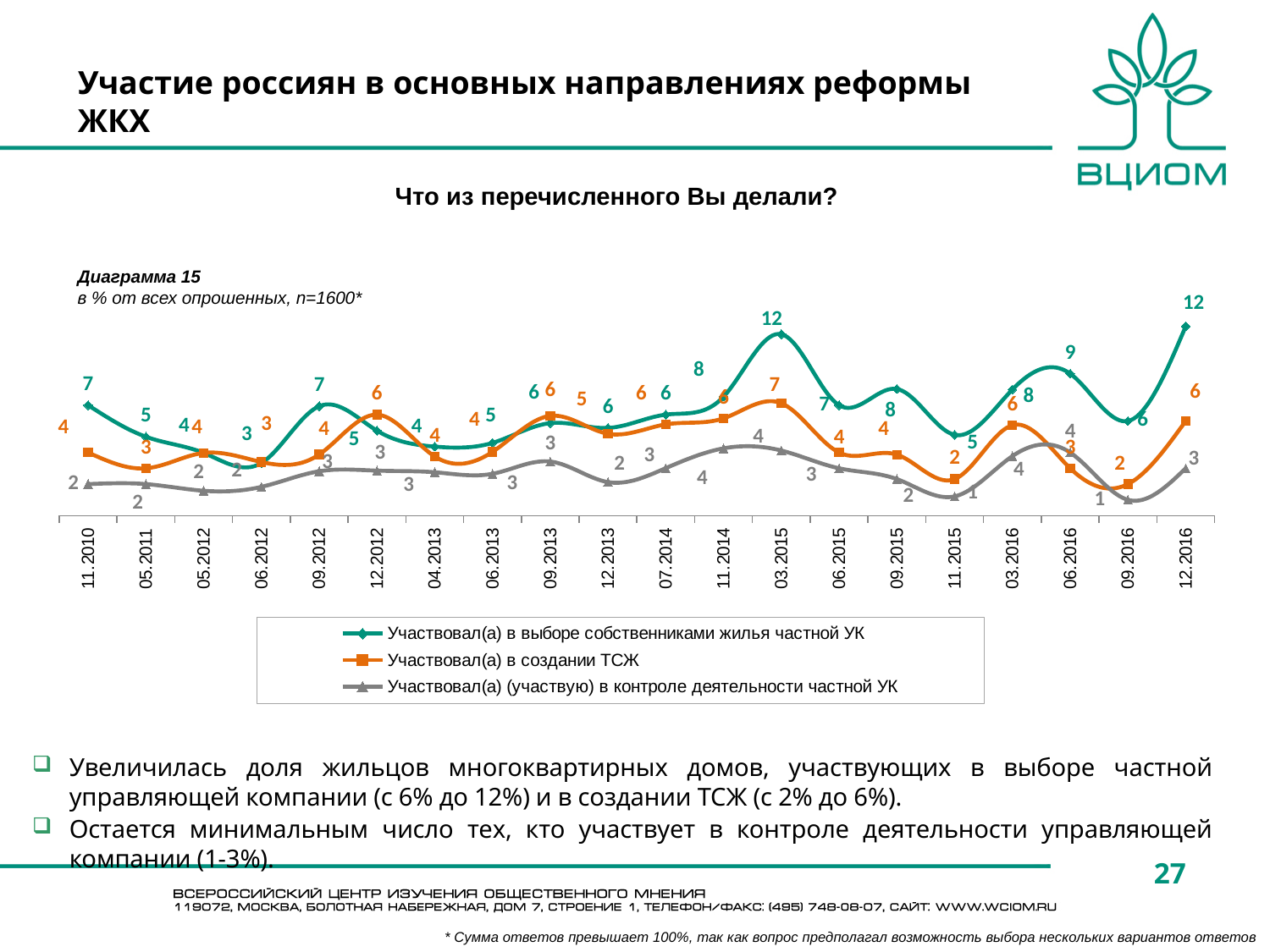
What is the highest value reached by the 'Участвовал(а) в создании ТСЖ' series? 7 Does the 'Участвовал(а) в выборе собственниками жилья частной УК' series rise or fall from 09.2016 to 12.2016? Rise In 03.2015, which is larger: 'Участвовал(а) в выборе собственниками жилья частной УК' or 'Участвовал(а) (участвую) в контроле деятельности частной УК'? Участвовал(а) в выборе собственниками жилья частной УК What is the value for 'Участвовал(а) (участвую) в контроле деятельности частной УК' in 11.2015? 1 What type of chart is shown on the slide? Line chart In 12.2016, what is the difference between 'Участвовал(а) в выборе собственниками жилья частной УК' and 'Участвовал(а) в создании ТСЖ'? 6 What is the lowest value of the 'Участвовал(а) в выборе собственниками жилья частной УК' series? 3 What is the value for 'Участвовал(а) в создании ТСЖ' in 03.2015? 7 How many series does the legend list? 3 What is the value for 'Участвовал(а) в выборе собственниками жилья частной УК' in 06.2016? 9 How many time points are shown on the x axis? 20 What is the value for 'Участвовал(а) в выборе собственниками жилья частной УК' in 03.2015? 12